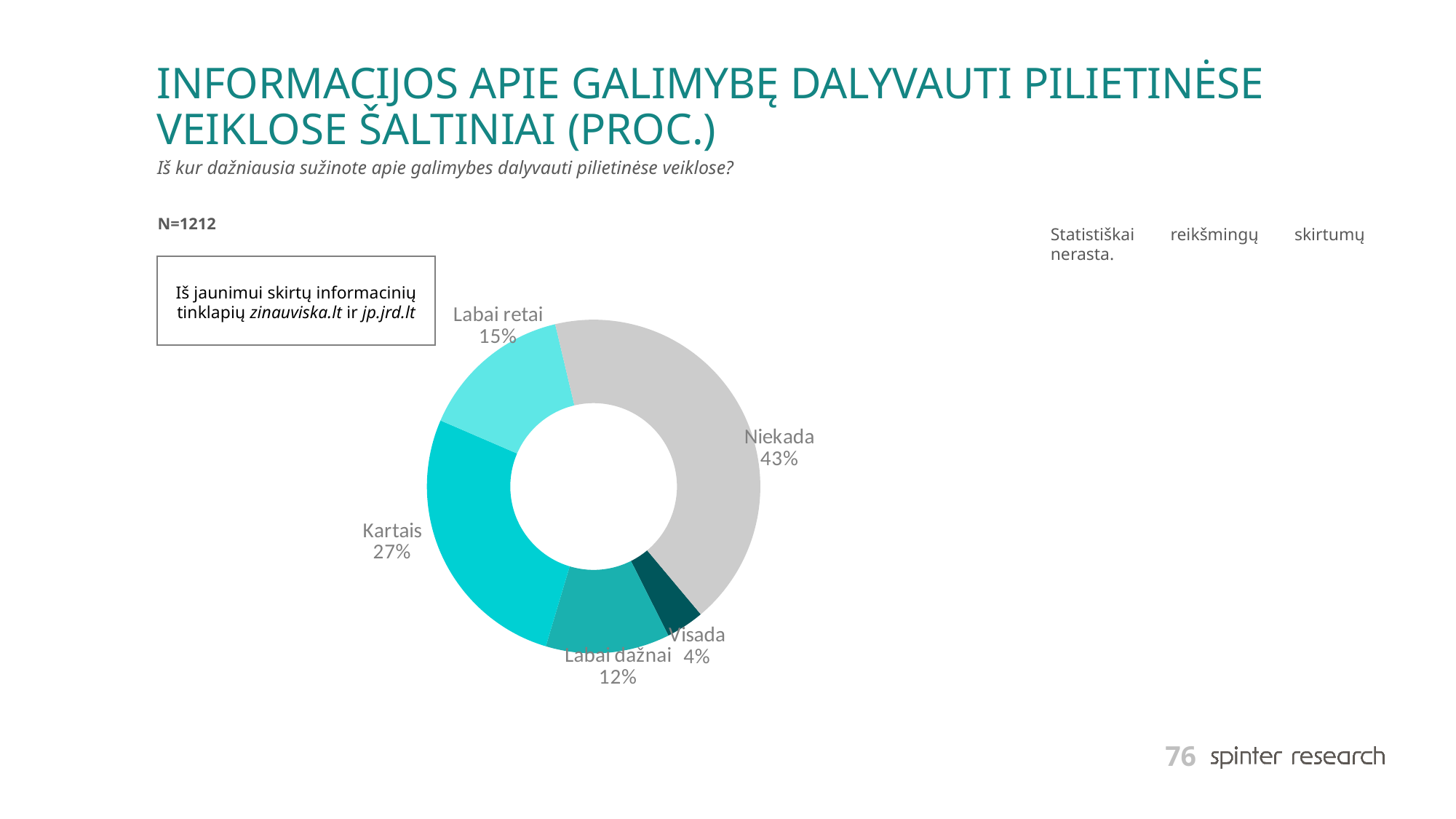
What is the value for Niekada? 43% How many categories are shown in the chart? 5 Which is larger, Labai retai or Labai dažnai? Labai retai What kind of chart is shown on the slide? Pie chart (doughnut) What is the value for Visada? 4% What is the value for Kartais? 27% What is the value for Labai dažnai? 12% Which category has the largest share? Niekada What is the sample size (N) stated on the slide? N=1212 Which category has the smallest share? Visada What is the difference between the values for Niekada and Kartais? 16% What is the value for Labai retai? 15%